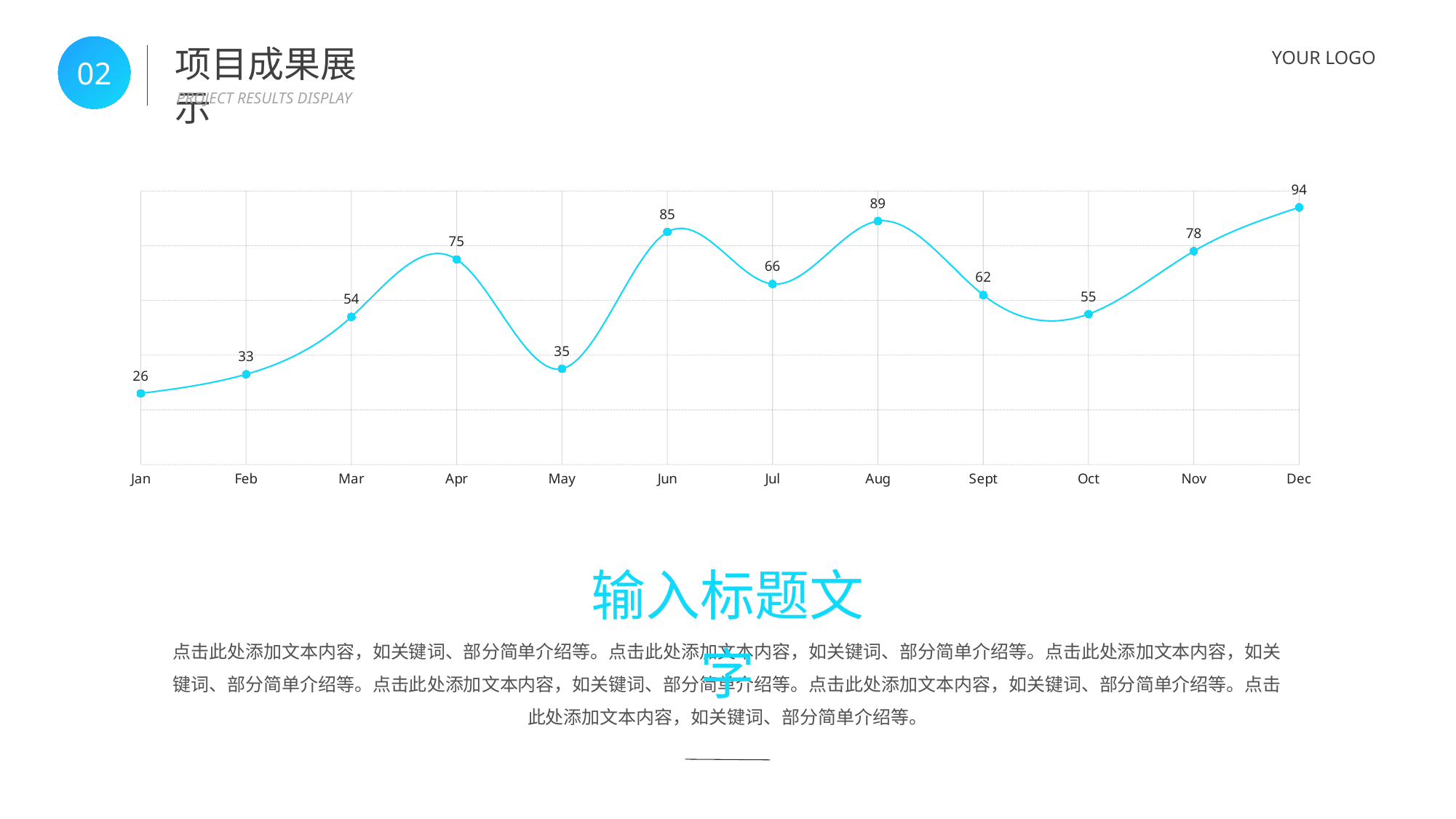
Which month has the highest value? Dec What kind of chart is shown on the slide? line chart What is the value for Oct? 55 Which month has the lowest value? Jan What is the value for Sept? 62 What is the difference between the values for Dec and Jan? 68 How many months are plotted on the x axis? 12 What is the difference between the values for Jun and May? 50 What is the value for Apr? 75 Does the value rise or fall from Apr to May? fall Which is larger, the value for Jul or the value for Nov? Nov Which is larger, the value for Aug or the value for Jun? Aug